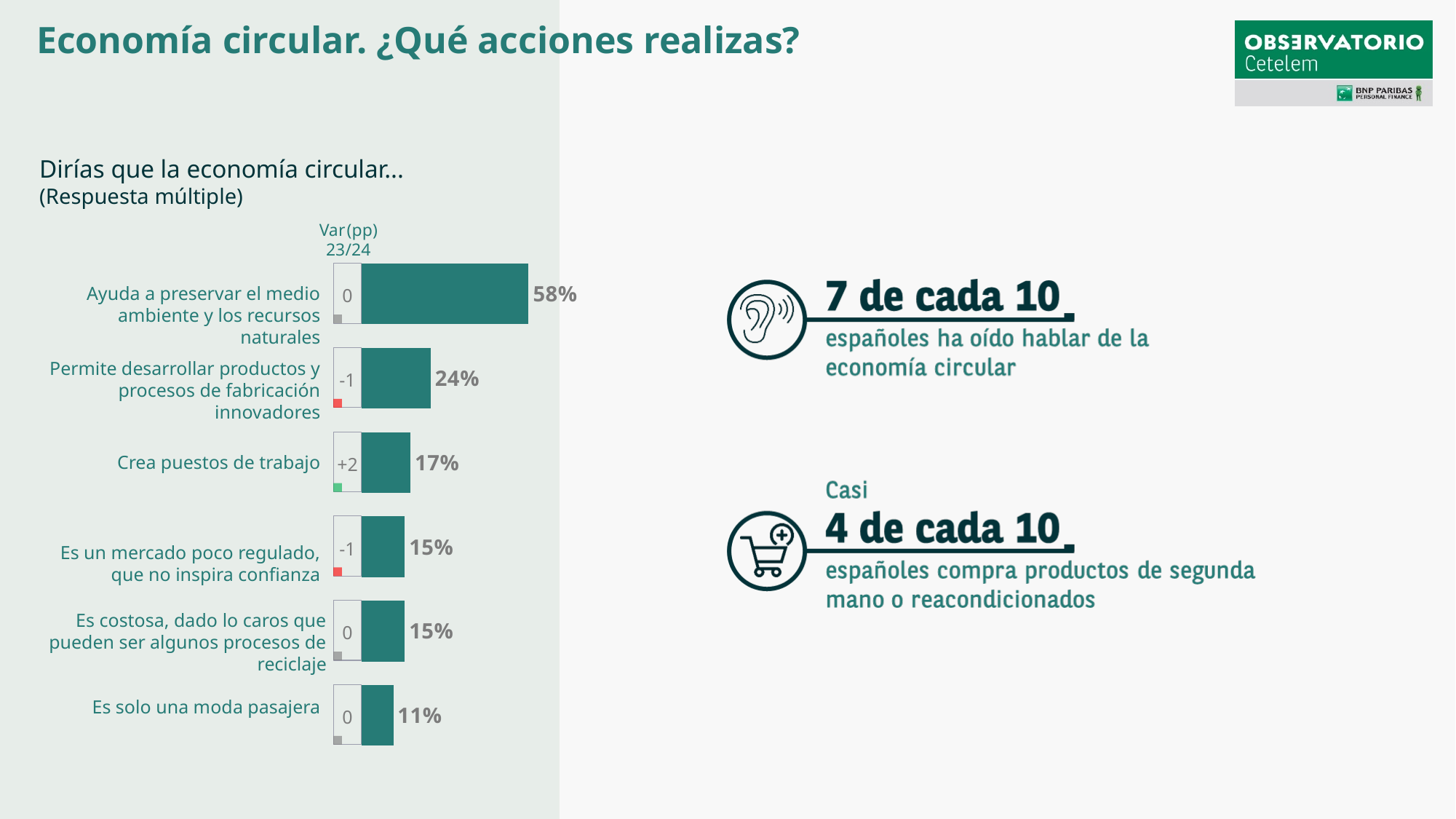
What is the difference between the value for "Ayuda a preservar el medio ambiente y los recursos naturales" and the value for "Permite desarrollar productos y procesos de fabricación innovadores"? 34 percentage points Which is larger: the value for "Crea puestos de trabajo" or the value for "Es solo una moda pasajera"? Crea puestos de trabajo How many categories are shown in the bar chart? 6 What is the value for "Es solo una moda pasajera"? 11% What is the Var(pp) 23/24 value shown for "Crea puestos de trabajo"? +2 Which category has the highest value in the chart? Ayuda a preservar el medio ambiente y los recursos naturales What is the question text shown above the chart? Dirías que la economía circular... (Respuesta múltiple) What kind of chart is shown on the slide? Bar chart What is the Var(pp) 23/24 value shown for "Es un mercado poco regulado, que no inspira confianza"? -1 Which category has the lowest value in the chart? Es solo una moda pasajera What is the value for "Crea puestos de trabajo"? 17% What percentage of respondents say the circular economy helps preserve the environment and natural resources ("Ayuda a preservar el medio ambiente y los recursos naturales")? 58%